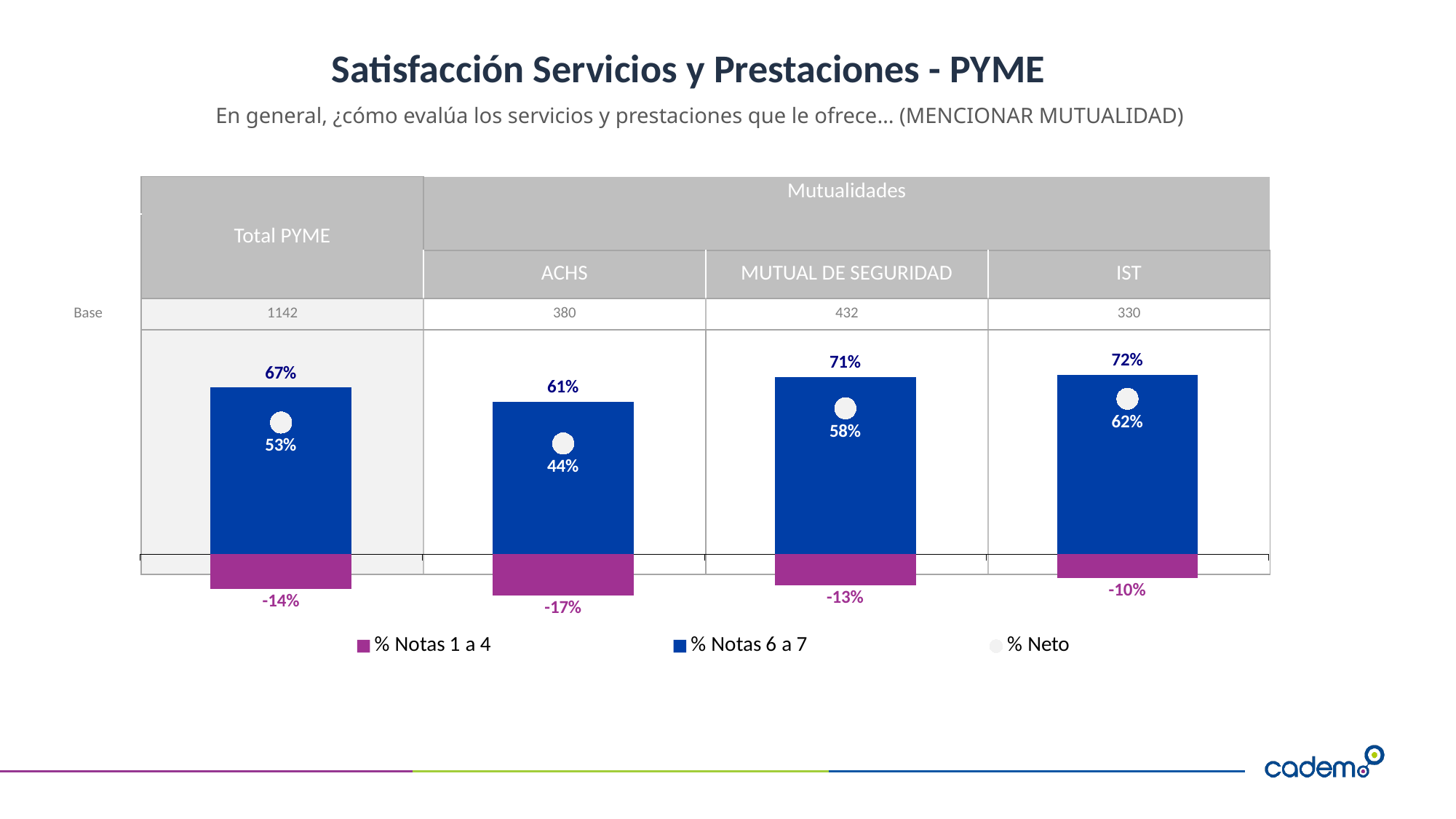
How many series does the legend list? 3 What kind of chart is shown on the slide? bar chart How many categories are shown on the chart? 4 Which category has the lowest % Neto value? ACHS What is the difference between the % Notas 6 a 7 values for IST and ACHS? 11% Which category has the highest % Notas 6 a 7 value? IST What is the % Notas 6 a 7 value for ACHS? 61% What is the base (number of respondents) for MUTUAL DE SEGURIDAD? 432 What is the % Neto value for Total PYME? 53% What is the % Neto value for MUTUAL DE SEGURIDAD? 58% Which is larger, the % Neto value for MUTUAL DE SEGURIDAD or for IST? IST What is the % Notas 1 a 4 value for IST? -10%